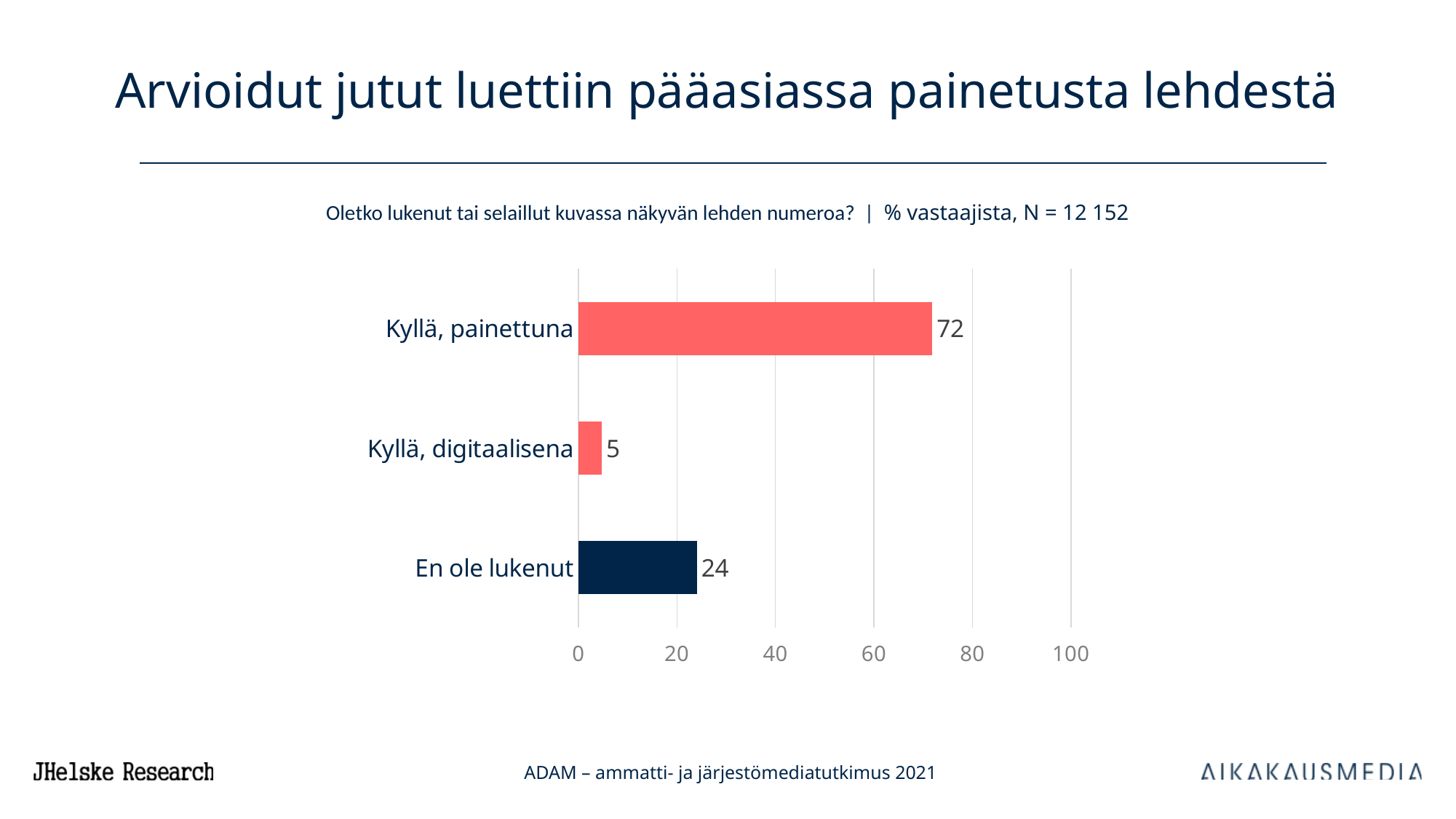
Which is larger, the value for "En ole lukenut" or the value for "Kyllä, digitaalisena"? En ole lukenut Is the value for "Kyllä, painettuna" greater or less than 60? greater Which category has the lowest value? Kyllä, digitaalisena What is the sample size (N) stated in the chart subtitle? 12 152 What is the value for "Kyllä, painettuna"? 72 What kind of chart is shown on the slide? bar chart What is the value for "En ole lukenut"? 24 What is the difference between the values for "Kyllä, painettuna" and "En ole lukenut"? 48 Which category has the highest value? Kyllä, painettuna How many categories are shown in the chart? 3 What is the value for "Kyllä, digitaalisena"? 5 What is the difference between the values for "En ole lukenut" and "Kyllä, digitaalisena"? 19